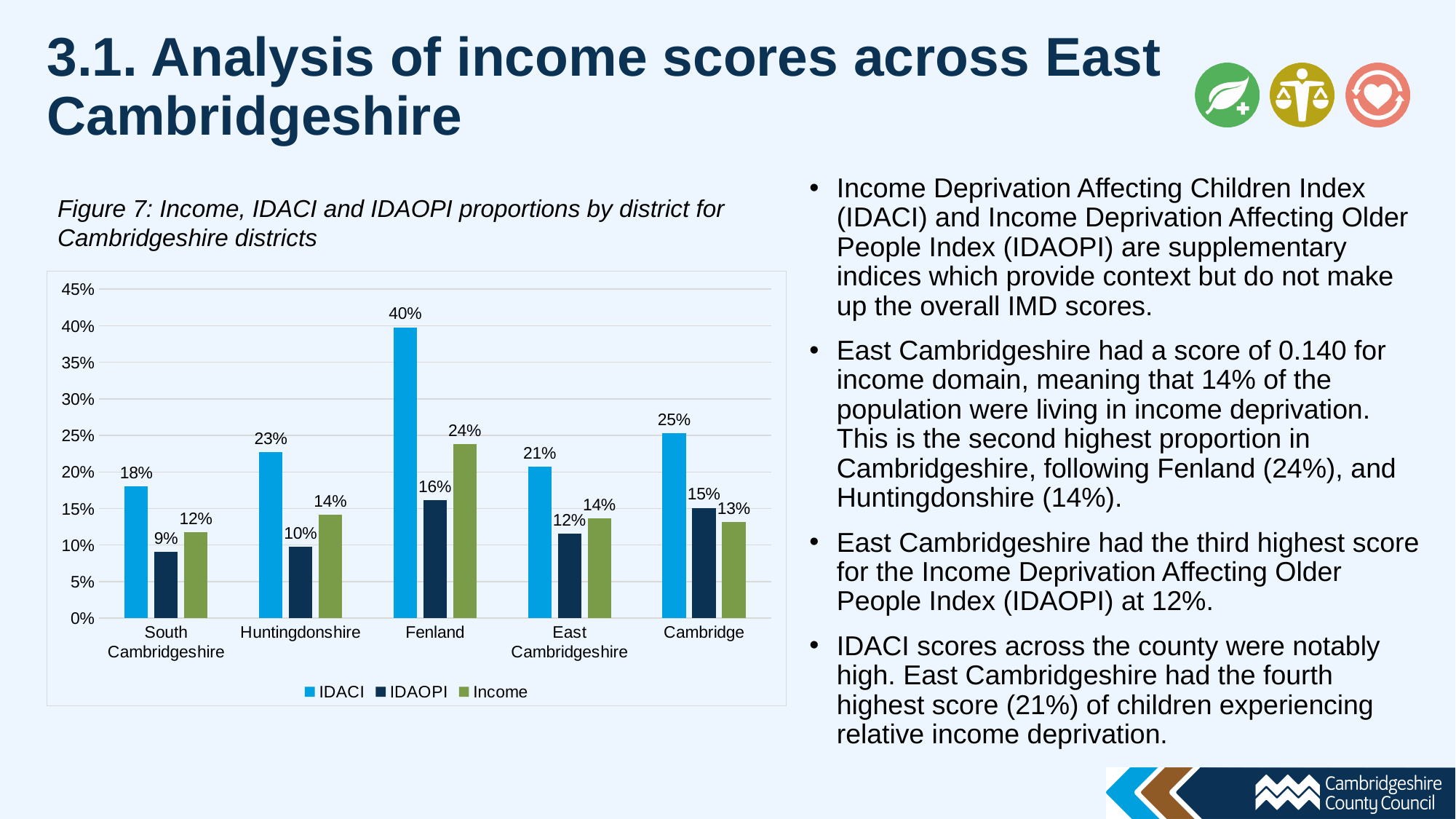
Which district has the highest Income value? Fenland Which is larger, the IDAOPI value for Cambridge or the IDAOPI value for East Cambridgeshire? Cambridge What is the difference between the IDACI values for Fenland and Cambridge? 15% Which series is shown in green in the legend? Income What is the Income value for Huntingdonshire? 14% How many districts are shown on the x axis? 5 What is the IDAOPI value for South Cambridgeshire? 9% What is the IDACI value for Fenland? 40% What kind of chart is shown on the slide? Bar chart How many series does the legend list? 3 What is the IDAOPI value for East Cambridgeshire? 12% Which district has the highest IDACI value? Fenland